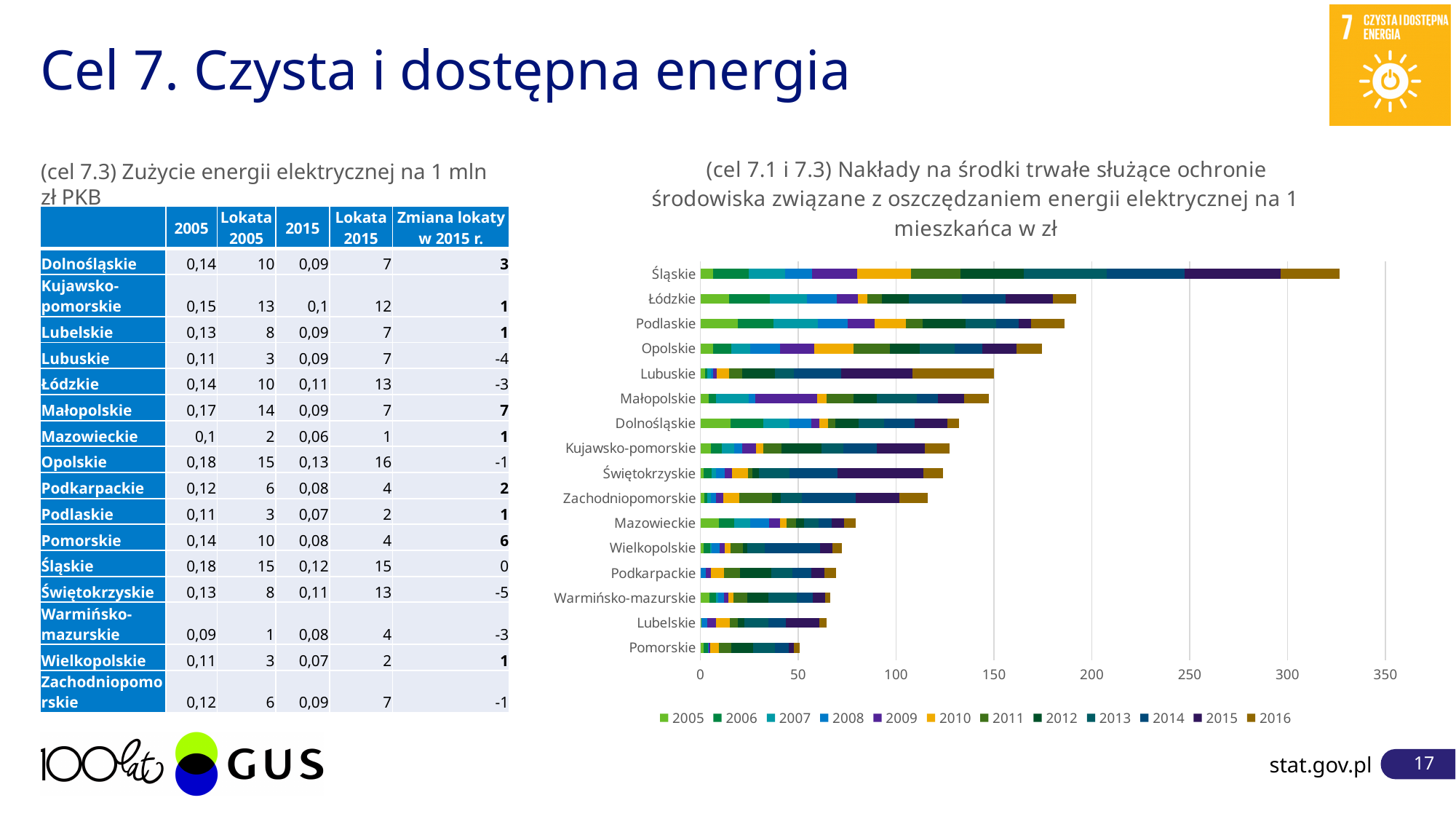
Is the total bar for Śląskie greater or less than 300? greater How many series (years) does the chart legend list? 12 Which has the larger total bar, Śląskie or Łódzkie? Śląskie Which voivodeship has the lowest total bar in the chart? Pomorskie Is the total bar for Pomorskie greater or less than 100? less Which has the larger total bar, Mazowieckie or Pomorskie? Mazowieckie How many voivodeships (categories) are plotted in the bar chart? 16 What is the first year listed in the chart legend? 2005 What kind of chart is shown on the slide? stacked bar chart Which voivodeship has the highest total bar in the chart? Śląskie Is the total bar for Mazowieckie greater or less than 100? less